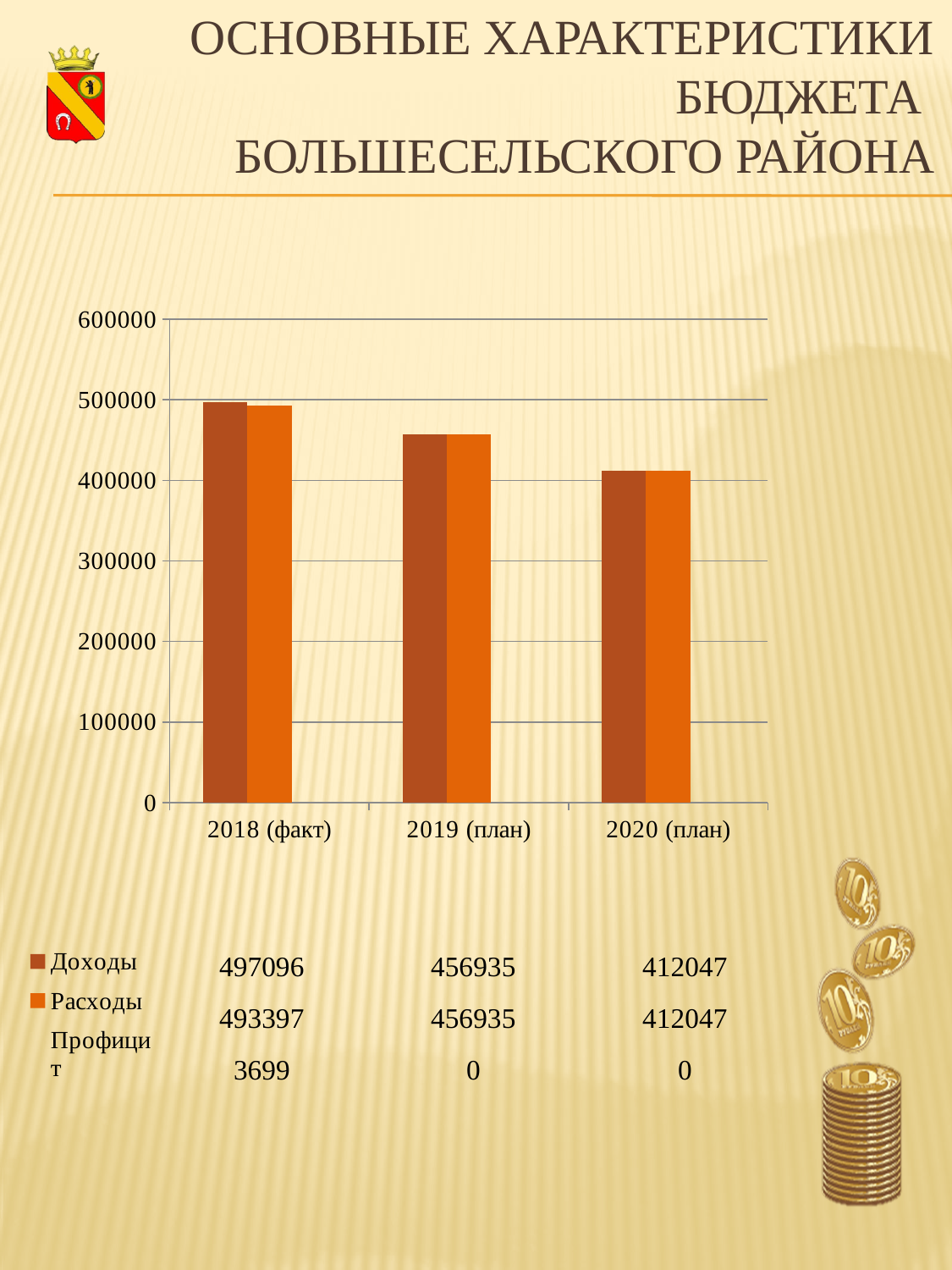
Which is larger in 2018 (факт): Доходы or Расходы? Доходы Which year has the lowest value of Расходы? 2020 (план) What is the value of Доходы for 2018 (факт)? 497096 Do the Доходы values rise or fall from 2018 (факт) to 2020 (план)? Fall What is the difference between Доходы in 2019 (план) and Доходы in 2020 (план)? 44888 What is the value of Расходы for 2018 (факт)? 493397 What is the value of Доходы for 2020 (план)? 412047 What is the value of Профицит for 2018 (факт)? 3699 How many year categories are shown on the x axis? 3 What is the difference between Доходы and Расходы in 2018 (факт)? 3699 Which year has the highest value of Доходы? 2018 (факт) What kind of chart is shown on the slide? Bar chart